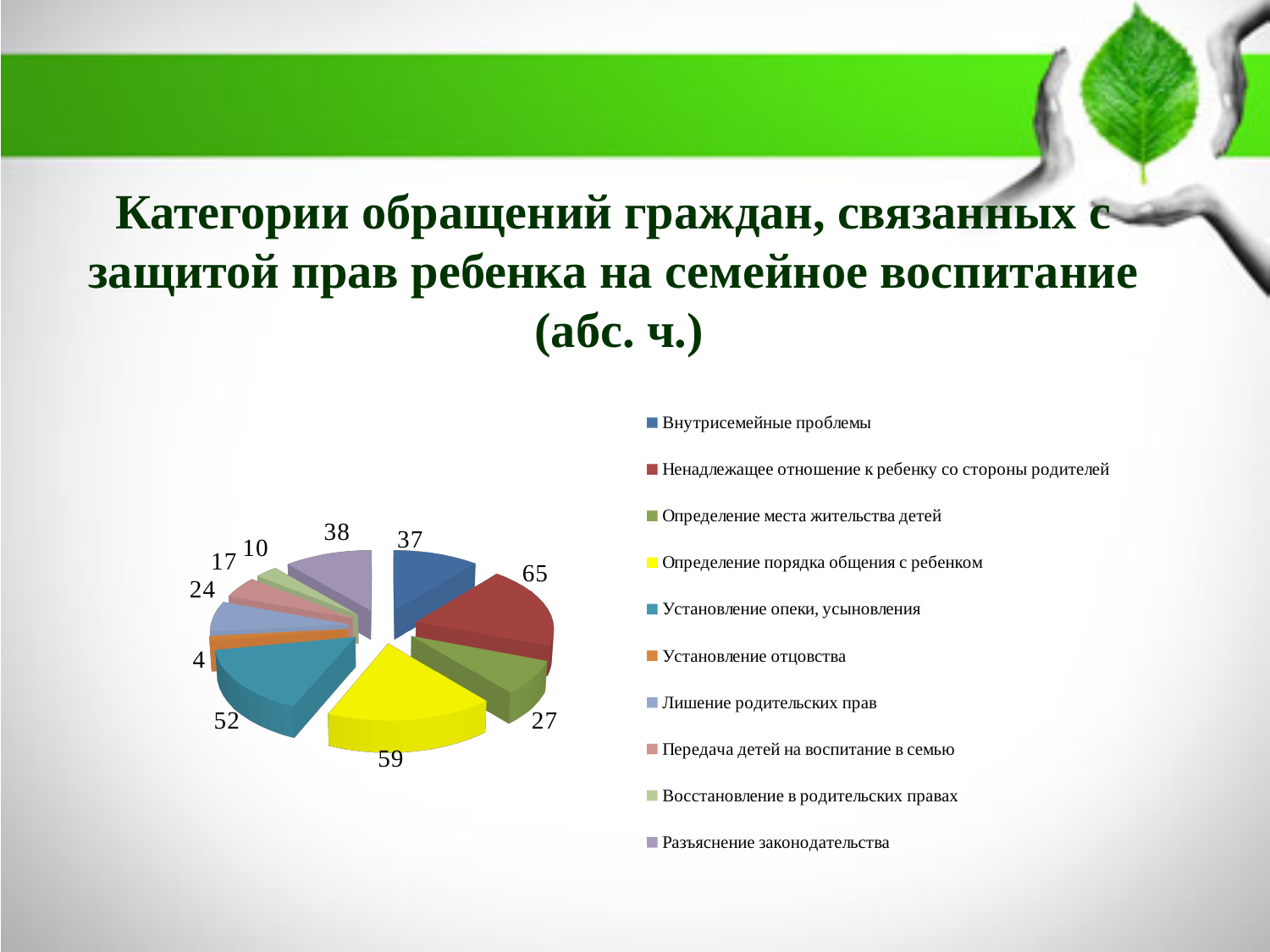
What is the value for "Определение порядка общения с ребенком"? 59 What is the total of all the values shown in the pie chart? 333 What is the value for "Ненадлежащее отношение к ребенку со стороны родителей"? 65 What is the value for "Разъяснение законодательства"? 38 What colour is the slice for "Определение порядка общения с ребенком"? Yellow What is the value for "Установление отцовства"? 4 Which category has the highest value? Ненадлежащее отношение к ребенку со стороны родителей What is the difference between the values for "Ненадлежащее отношение к ребенку со стороны родителей" and "Установление опеки, усыновления"? 13 What kind of chart is shown on the slide? Pie chart How many categories does the pie chart have? 10 Which category has the lowest value? Установление отцовства Which is larger: the value for "Лишение родительских прав" or the value for "Передача детей на воспитание в семью"? Лишение родительских прав